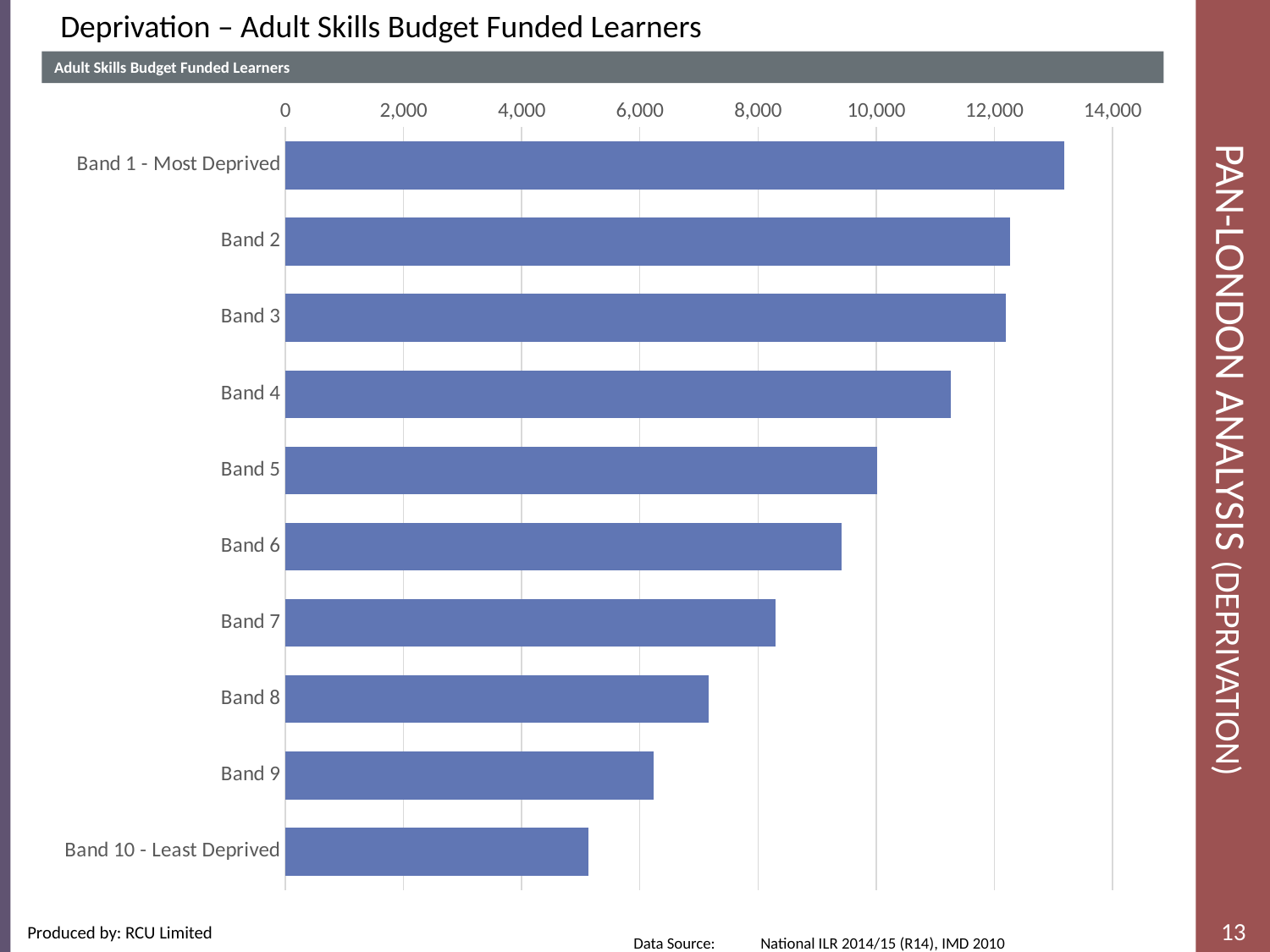
Is the value for Band 9 greater or less than 8,000? less Which band has the highest number of Adult Skills Budget funded learners? Band 1 - Most Deprived What is the highest value labelled on the horizontal axis? 14,000 What is the title shown in the header bar above the chart? Adult Skills Budget Funded Learners Which band has the lowest number of Adult Skills Budget funded learners? Band 10 - Least Deprived Is the value for Band 7 greater or less than 8,000? greater Is the value for Band 1 - Most Deprived greater or less than 12,000? greater What kind of chart is shown on the slide? bar chart Do the values rise or fall as you move from Band 1 down to Band 10? fall How many deprivation bands are plotted on the chart? 10 Which has more funded learners, Band 4 or Band 6? Band 4